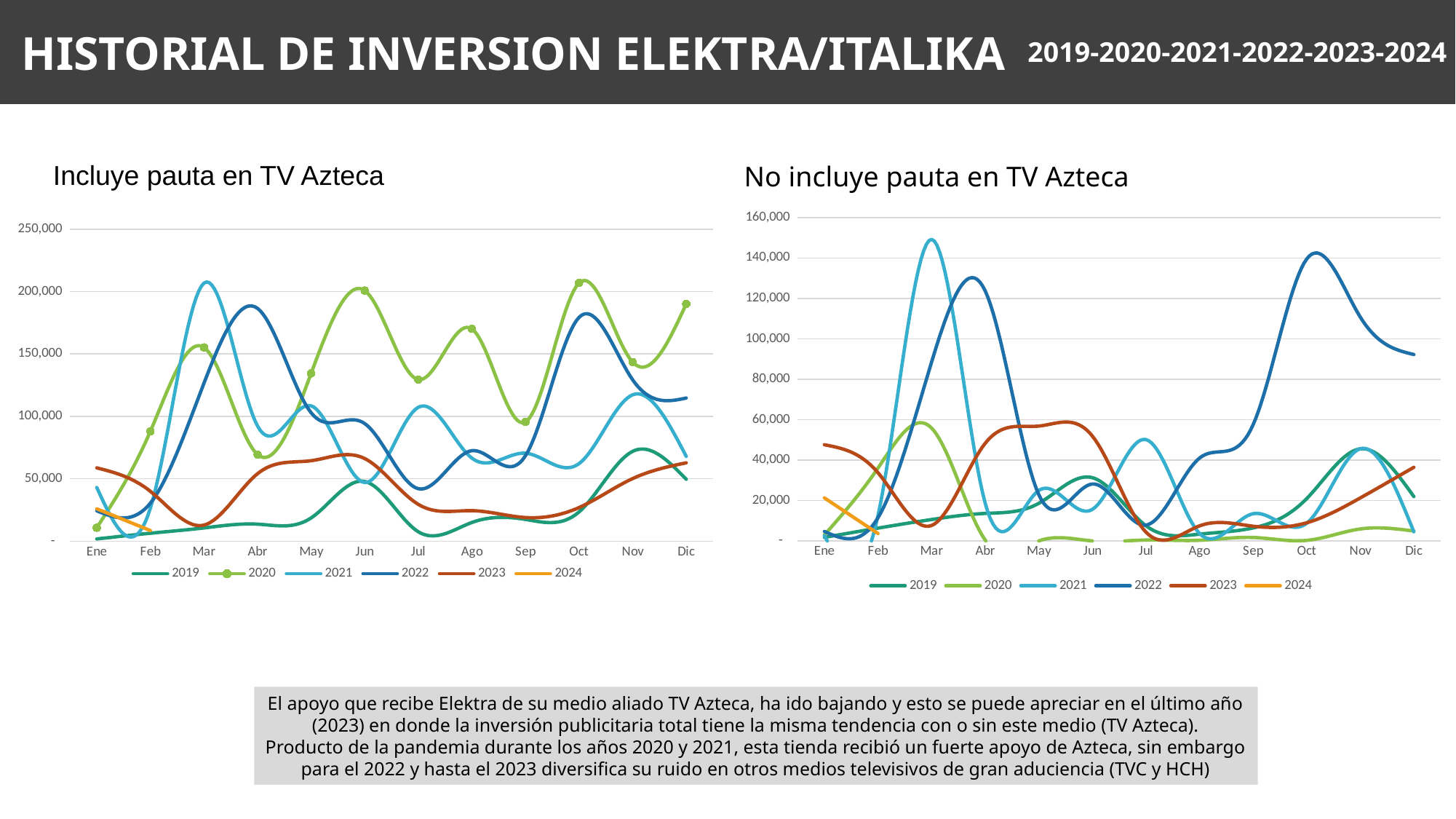
In the 'Incluye pauta en TV Azteca' chart, is the value for 2021 in Mar greater or less than 150,000? greater In the 'Incluye pauta en TV Azteca' chart, does the 2020 series rise or fall from Jun to Jul? Fall How many series does the legend of the 'No incluye pauta en TV Azteca' chart list? 6 In the 'No incluye pauta en TV Azteca' chart, does the 2022 series rise or fall from Jul to Oct? Rise In the 'Incluye pauta en TV Azteca' chart, is the value for 2022 in Abr greater or less than 150,000? greater How many months are shown on the x axis of the 'Incluye pauta en TV Azteca' chart? 12 In the 'No incluye pauta en TV Azteca' chart, is the value for 2023 in Jun greater or less than 80,000? less What kind of chart is the 'Incluye pauta en TV Azteca' chart? Line chart What is the title of the chart on the right side of the slide? No incluye pauta en TV Azteca